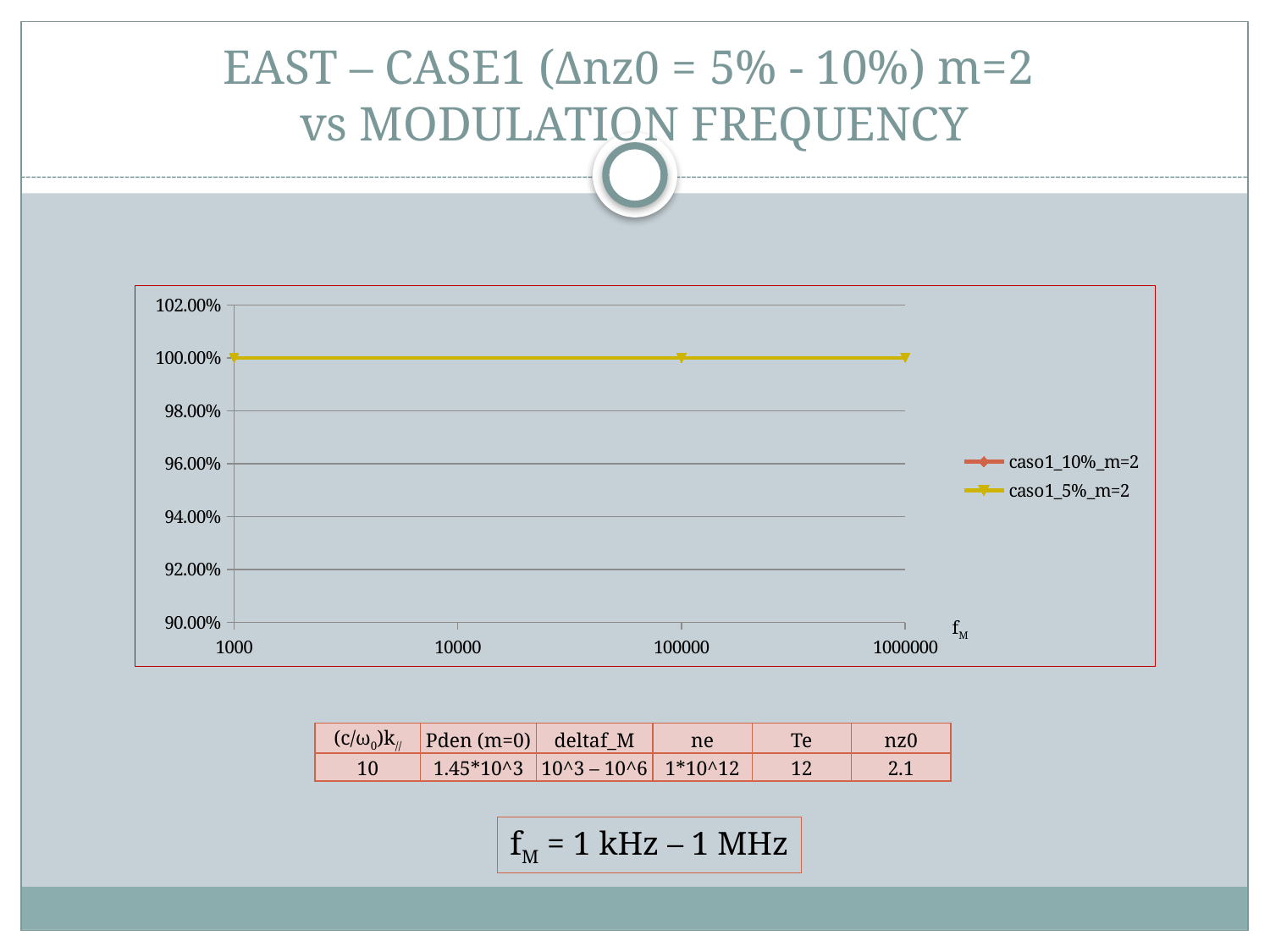
What is the lowest value shown on the y axis of the chart? 90.00% What is the value of the caso1_5%_m=2 series at f_M = 1000000? 100.00% What is the difference between the caso1_5%_m=2 values at f_M = 1000 and f_M = 1000000? 0.00% Do the plotted values rise, fall, or stay flat as f_M increases from 1000 to 1000000? stay flat What kind of chart is shown on the slide? line chart What is the highest value shown on the y axis of the chart? 102.00% Is the value of the caso1_5%_m=2 series at f_M = 100000 greater or less than 98.00%? greater What is the label of the x axis of the chart? f_M What is the value of the caso1_5%_m=2 series at f_M = 1000? 100.00% How many series does the chart legend list? 2 How many data points are plotted along the x axis for the caso1_5%_m=2 series? 3 What are the names of the two series in the chart legend? caso1_10%_m=2 and caso1_5%_m=2